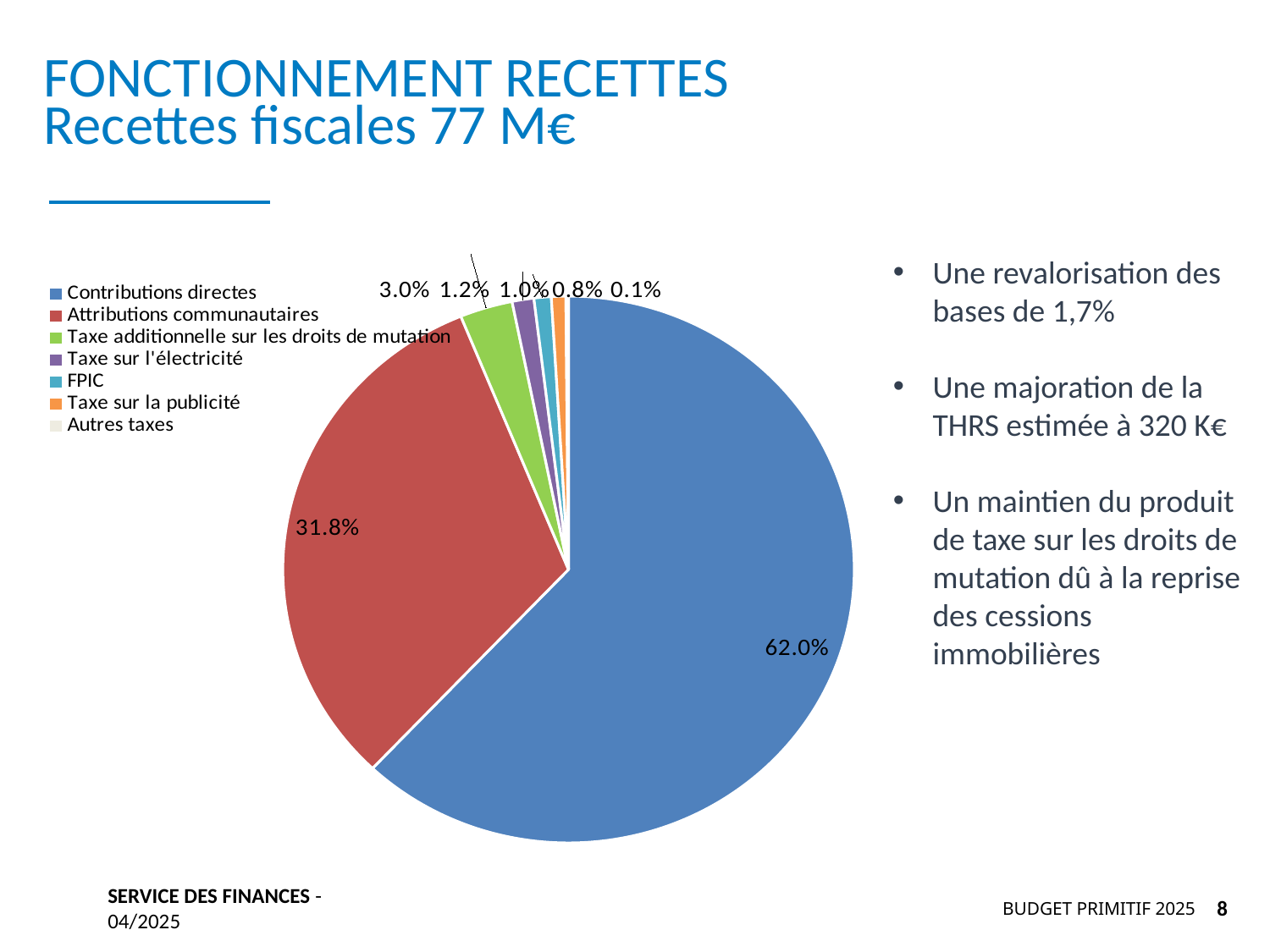
What kind of chart is shown on the slide? Pie chart What share of the pie does Contributions directes represent? 62.0% What share of the pie does Autres taxes represent? 0.1% What share of the pie does Taxe additionnelle sur les droits de mutation represent? 3.0% What colour is the slice for Contributions directes? Blue What is the difference in percentage points between Contributions directes and Attributions communautaires? 30.2 percentage points Which category has the largest slice of the pie? Contributions directes What share of the pie does Taxe sur l'électricité represent? 1.2% Which category has the smallest slice of the pie? Autres taxes What share of the pie does Attributions communautaires represent? 31.8% How many categories does the legend of the pie chart list? 7 Which is larger: Attributions communautaires or Taxe additionnelle sur les droits de mutation? Attributions communautaires